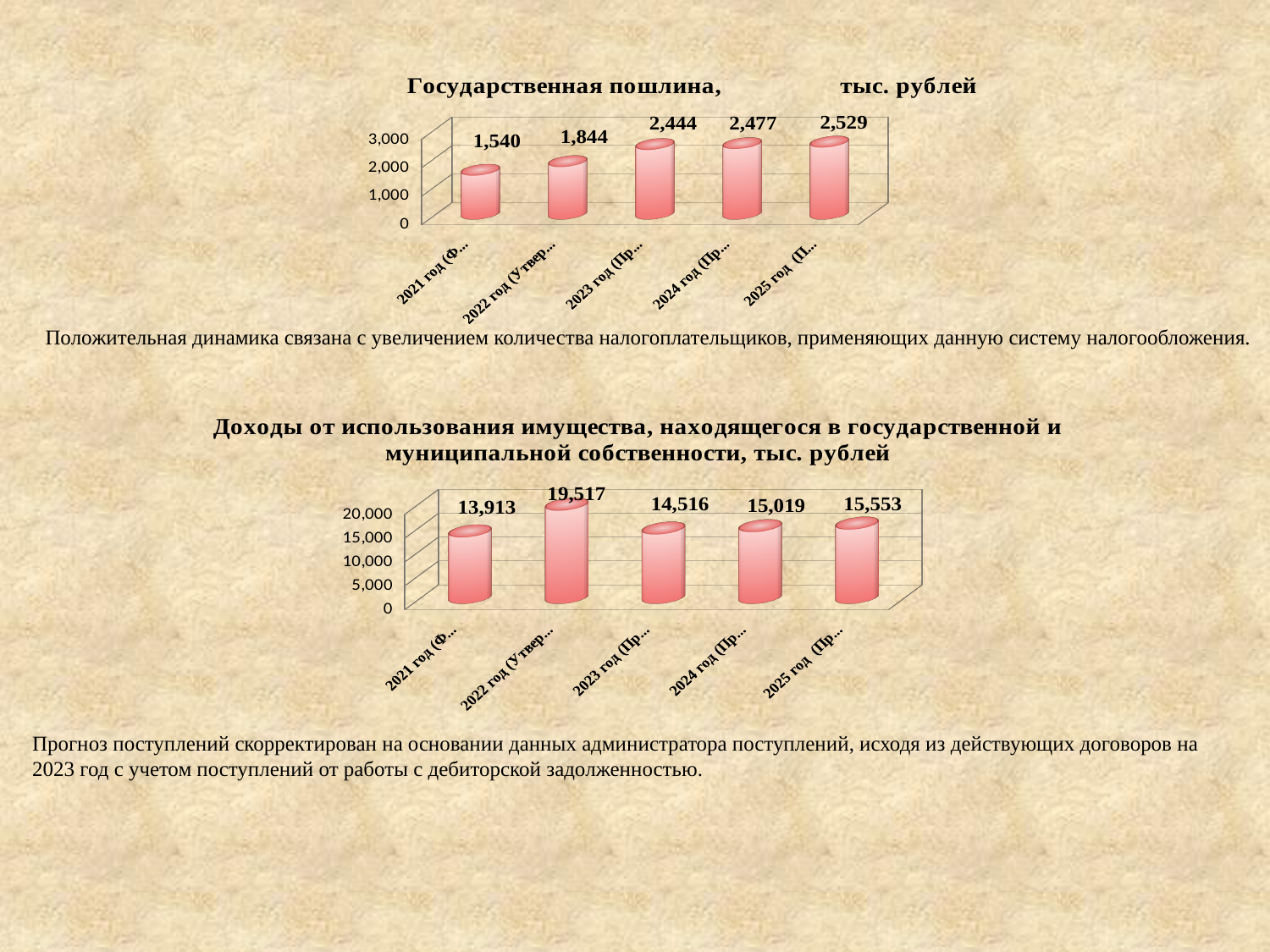
In the bottom chart 'Доходы от использования имущества', which is larger, the value for 2021 or the value for 2023? 2023 In the top chart 'Государственная пошлина', what is the value for 2025? 2,529 In the top chart 'Государственная пошлина', how many bars are plotted? 5 In the top chart 'Государственная пошлина', what is the difference between the 2023 value and the 2022 value? 600 In the top chart 'Государственная пошлина', do the values rise or fall from 2021 to 2025? rise In the bottom chart 'Доходы от использования имущества', what is the difference between the 2025 value and the 2021 value? 1,640 In the top chart 'Государственная пошлина', what is the value for 2021? 1,540 In the bottom chart 'Доходы от использования имущества', which year has the highest value? 2022 In the top chart 'Государственная пошлина', which year has the lowest value? 2021 In the bottom chart 'Доходы от использования имущества', what is the value for 2024? 15,019 In the bottom chart 'Доходы от использования имущества', what is the value for 2022? 19,517 What kind of chart is the bottom chart 'Доходы от использования имущества'? bar chart